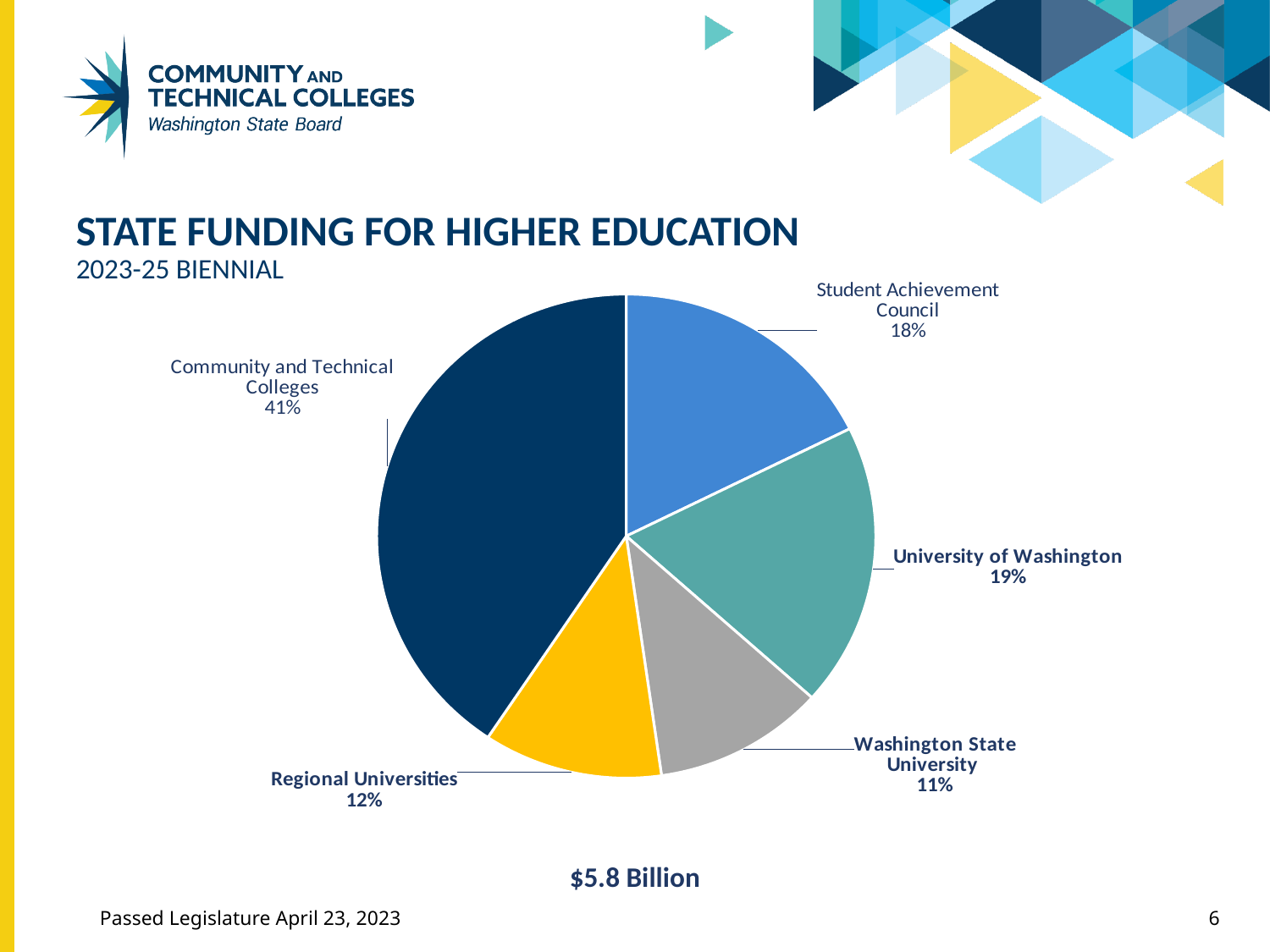
What share of state funding for higher education goes to Community and Technical Colleges? 41% What percentage of the pie is the University of Washington slice? 19% What kind of chart is shown on the slide? pie chart What share is labelled for the Student Achievement Council? 18% How many slices does the pie chart have? 5 What share does Washington State University receive? 11% Which category has the smallest share of the pie? Washington State University What percentage is shown for Regional Universities? 12% What is the difference in percentage points between Community and Technical Colleges and the University of Washington? 22 What total funding amount is shown below the pie chart? $5.8 Billion Which category has the largest share of the pie? Community and Technical Colleges Which receives a larger share, Regional Universities or Washington State University? Regional Universities